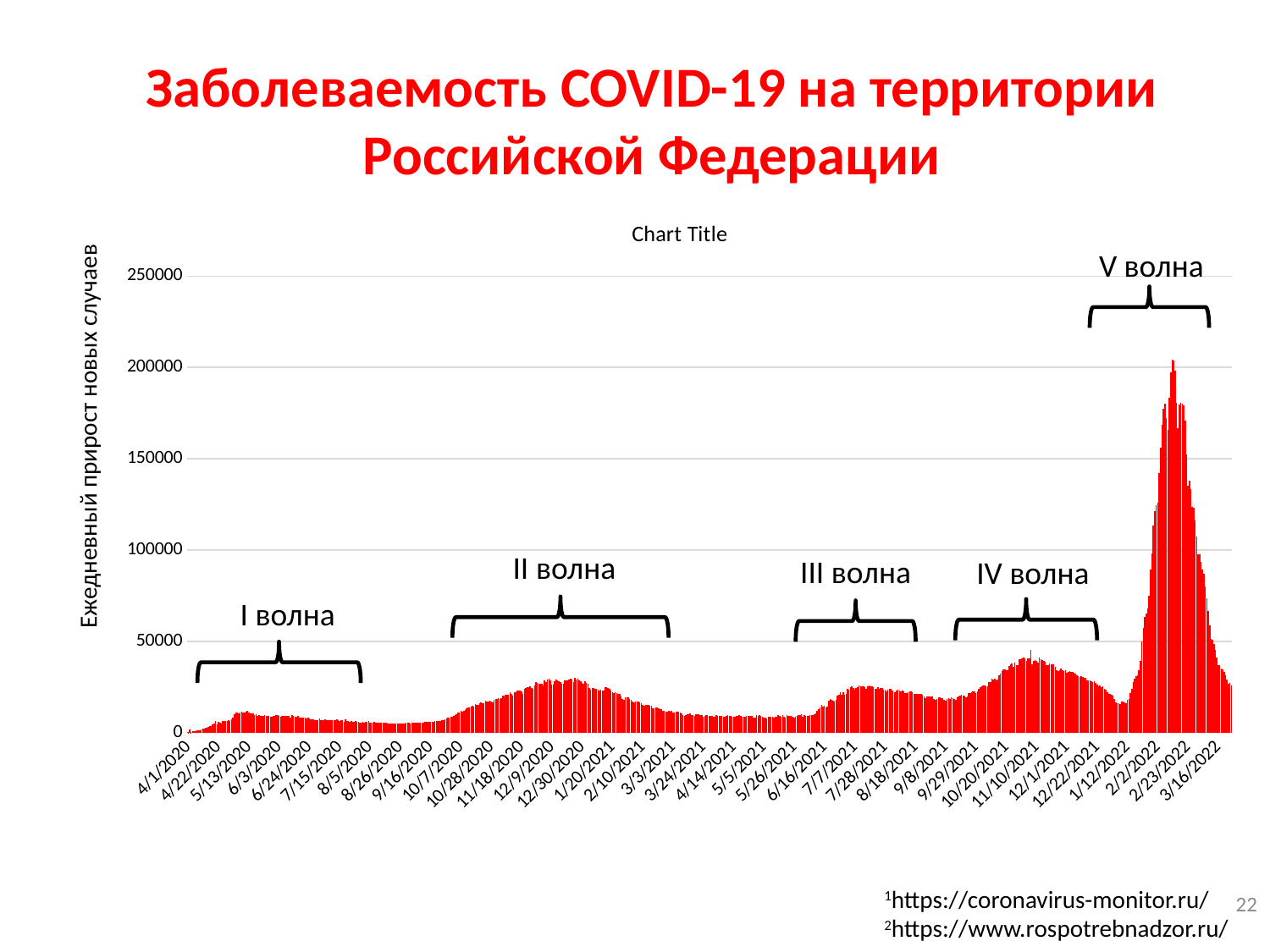
Is the peak value during IV волна greater or less than 50000? less Which wave (волна) has the highest peak of daily new cases? V волна Is the peak value during II волна greater or less than 50000? less What kind of chart is shown on the slide? bar chart Is the peak value during I волна greater or less than 50000? less How many waves (волна) are annotated on the chart? 5 Which wave has a lower peak, I волна or III волна? I волна What is the highest value shown on the vertical axis? 250000 What is the label of the vertical axis? Ежедневный прирост новых случаев Do the values rise or fall between 2/23/2022 and 3/16/2022? fall Which wave has a higher peak, II волна or IV волна? IV волна